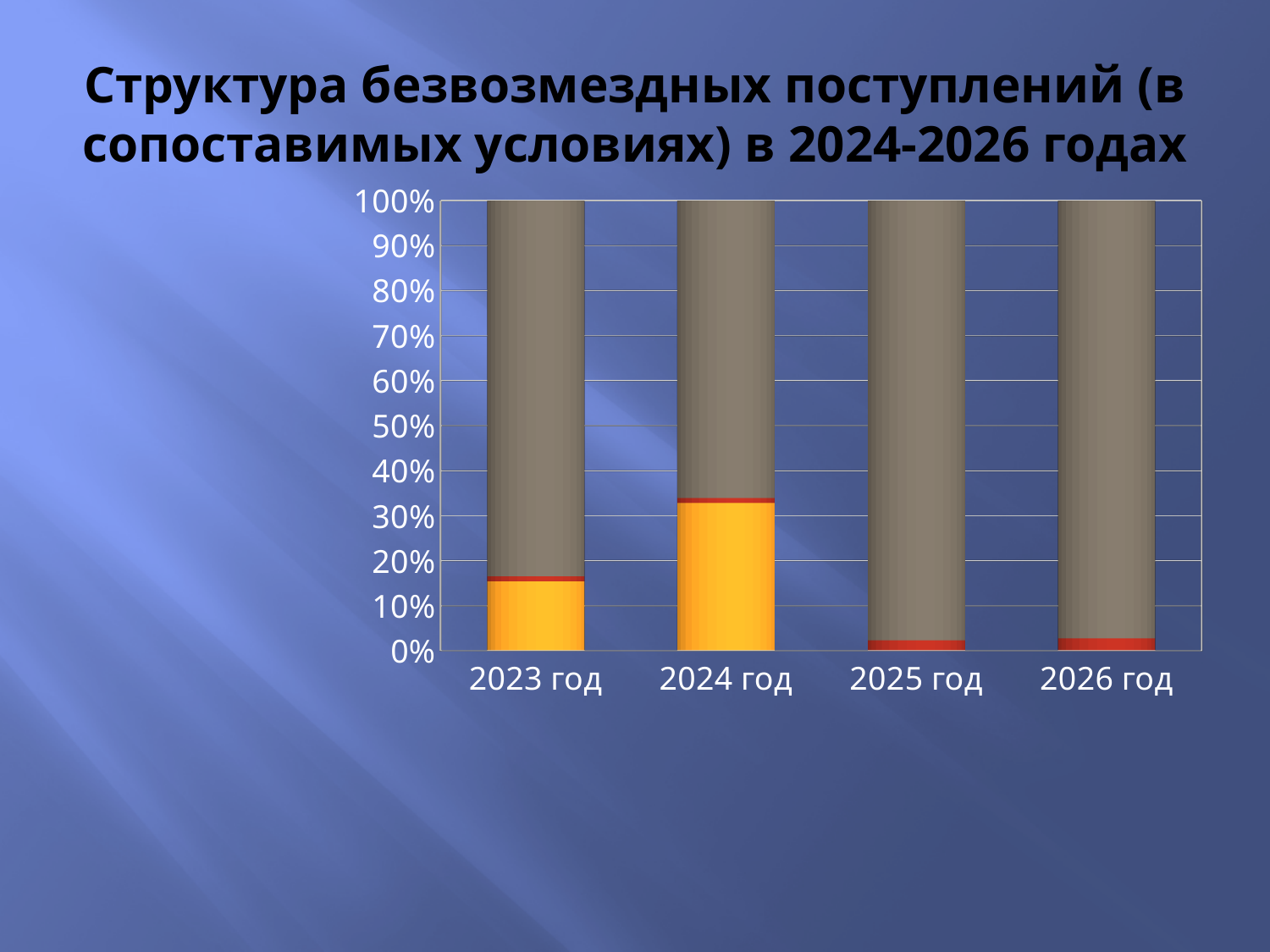
Is the grey segment of the 2024 год bar greater or less than 70%? less Is the yellow segment of the 2023 год bar greater or less than 20%? less Is the grey segment of the 2023 год bar greater or less than 80%? greater Is the yellow segment larger in the 2023 год bar or the 2024 год bar? 2024 год What is the highest value shown on the vertical axis of the chart? 100% Which year has the largest yellow segment in its bar? 2024 год What kind of chart is shown on the slide? Stacked bar chart How many years (categories) are shown on the x axis of the chart? 4 What is the title of the chart on the slide? Структура безвозмездных поступлений (в сопоставимых условиях) в 2024-2026 годах Which year is the first category on the x axis of the chart? 2023 год